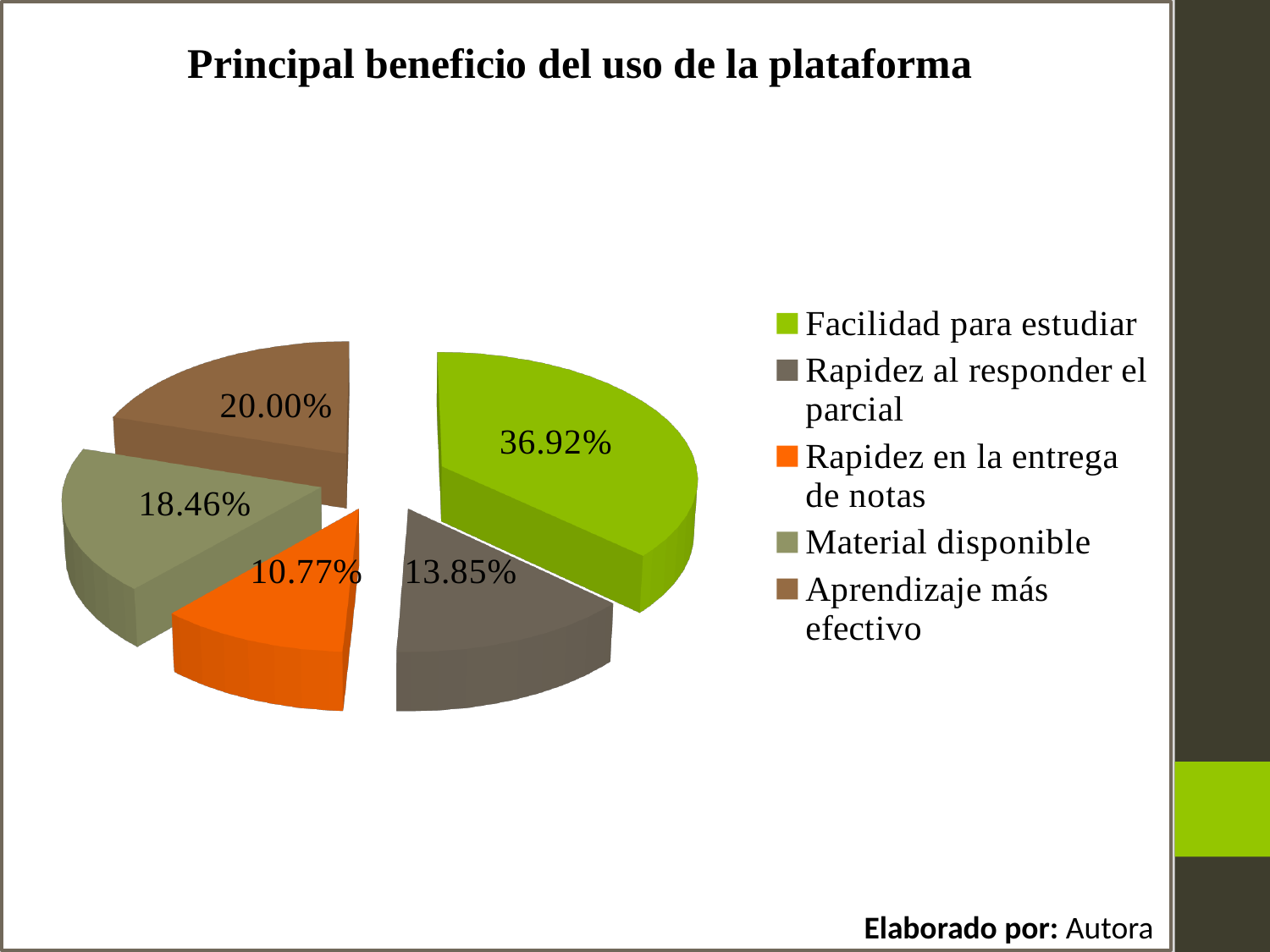
What is the title of the chart? Principal beneficio del uso de la plataforma Which category has the largest share of the pie? Facilidad para estudiar What percentage is shown for "Material disponible"? 18.46% What percentage of the pie corresponds to "Facilidad para estudiar"? 36.92% What percentage is shown for "Rapidez al responder el parcial"? 13.85% How many categories does the legend list? 5 What percentage is shown for "Aprendizaje más efectivo"? 20.00% What is the difference between the shares of "Facilidad para estudiar" and "Aprendizaje más efectivo"? 16.92% What percentage is shown for "Rapidez en la entrega de notas"? 10.77% Which is larger, the share for "Material disponible" or the share for "Rapidez al responder el parcial"? Material disponible Which category has the smallest share of the pie? Rapidez en la entrega de notas What type of chart is shown on the slide? Pie chart